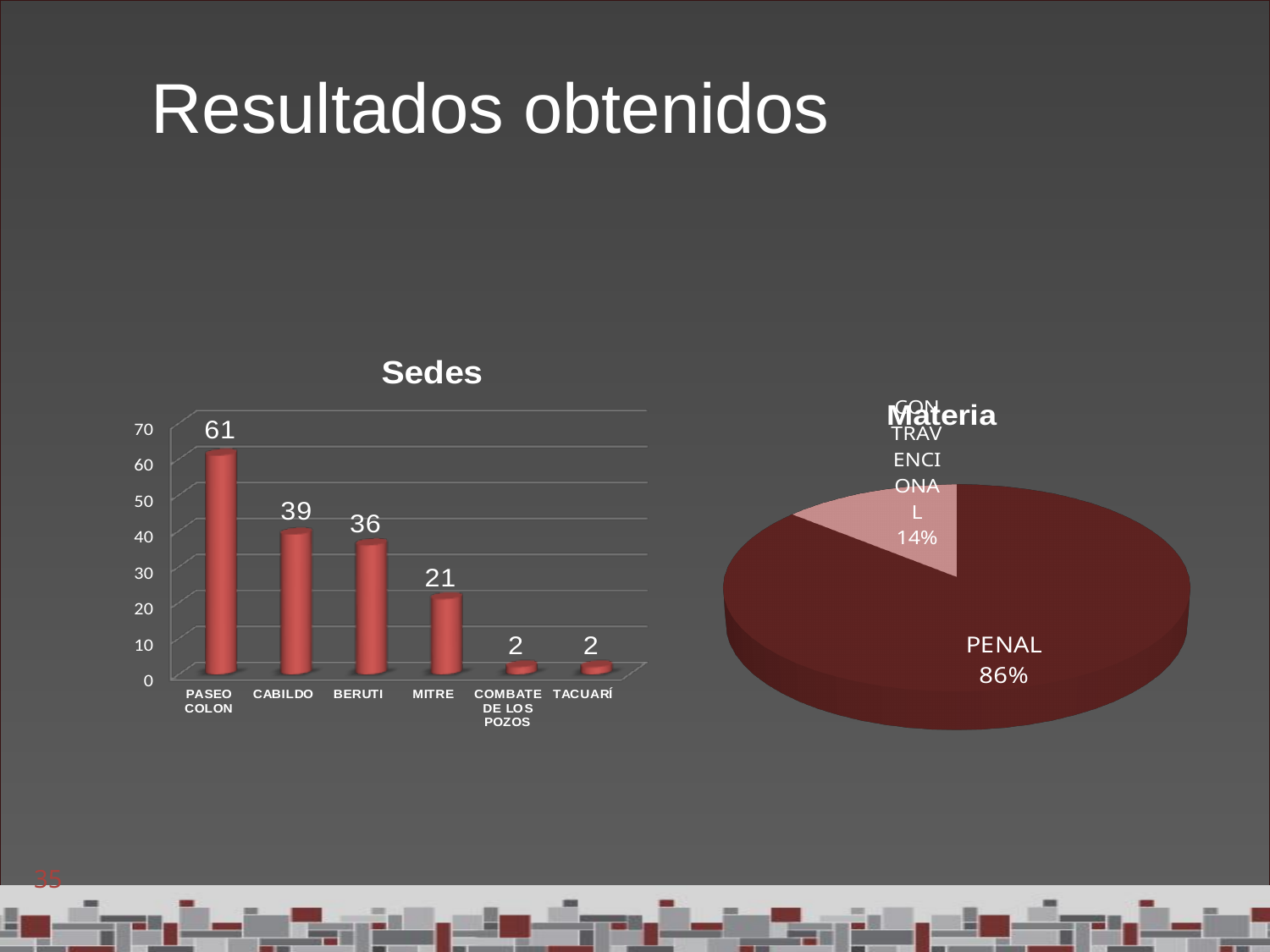
In the 'Sedes' chart, what is the value for PASEO COLON? 61 What kind of chart is the 'Materia' chart? Pie chart In the 'Sedes' chart, do the values rise or fall from left to right along the x axis? Fall In the 'Sedes' chart, which is larger, the value for CABILDO or the value for BERUTI? CABILDO In the 'Sedes' chart, what is the difference between the values for PASEO COLON and CABILDO? 22 What kind of chart is the 'Sedes' chart? Bar chart In the 'Sedes' chart, what is the value for MITRE? 21 In the 'Sedes' chart, what is the value for BERUTI? 36 In the 'Sedes' chart, which category has the highest value? PASEO COLON In the 'Sedes' chart, how many categories are shown on the x axis? 6 In the 'Materia' pie chart, what share does CONTRAVENCIONAL have? 14% In the 'Materia' pie chart, what share does PENAL have? 86%